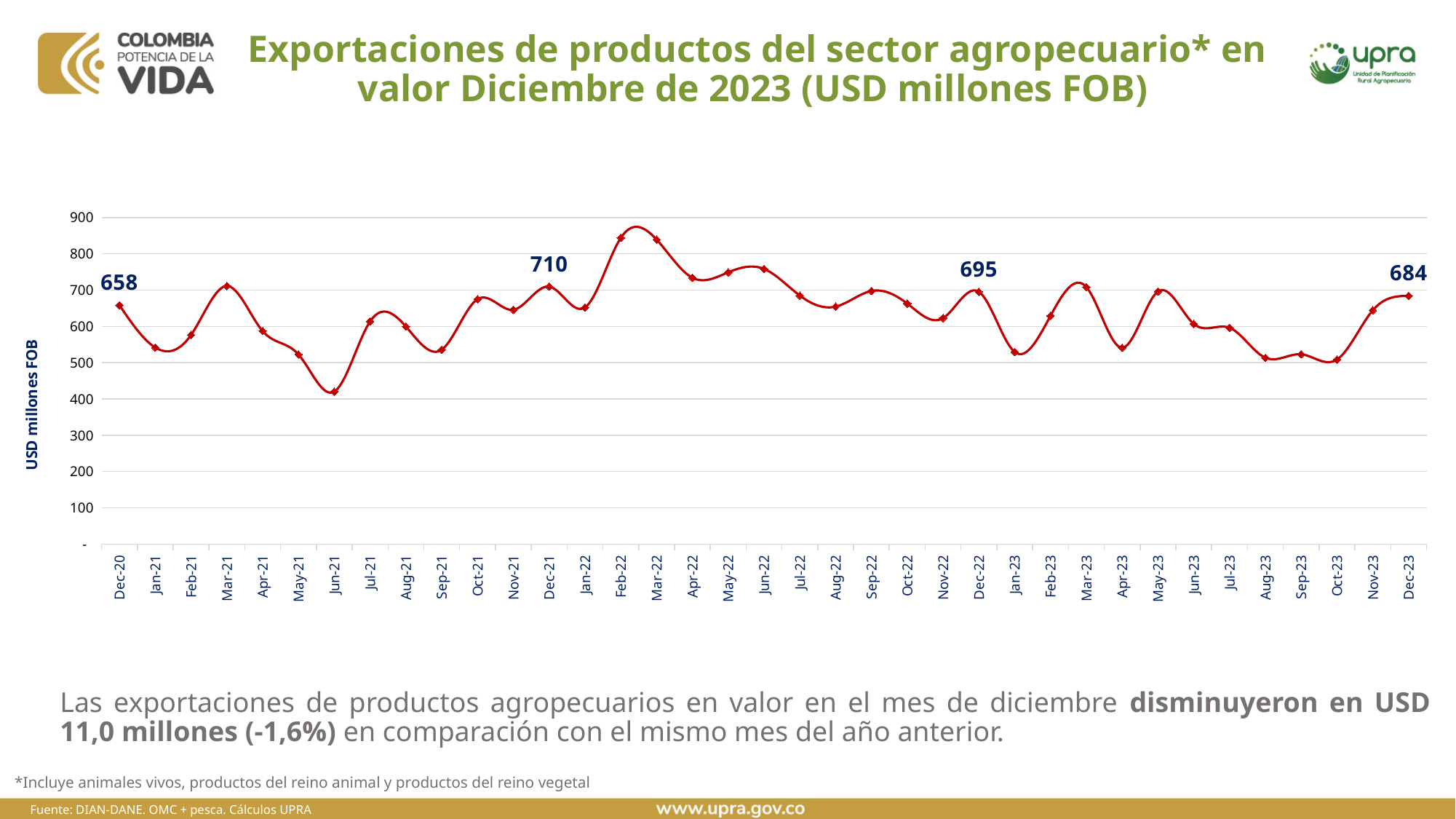
What is the value for Dec-21? 710 Which is larger, the value for Dec-21 or the value for Dec-22? Dec-21 What is the value for Dec-22? 695 Is the value for Feb-22 greater or less than 800? greater What is the difference between the values for Dec-21 and Dec-20? 52 What is the value for Dec-23? 684 What is the label of the vertical axis? USD millones FOB What is the value for Dec-20? 658 What type of chart is shown on the slide? Line chart What is the difference between the values for Dec-22 and Dec-23? 11 Which month has the lowest value on the chart? Jun-21 Is the value for Jun-21 greater or less than 500? less